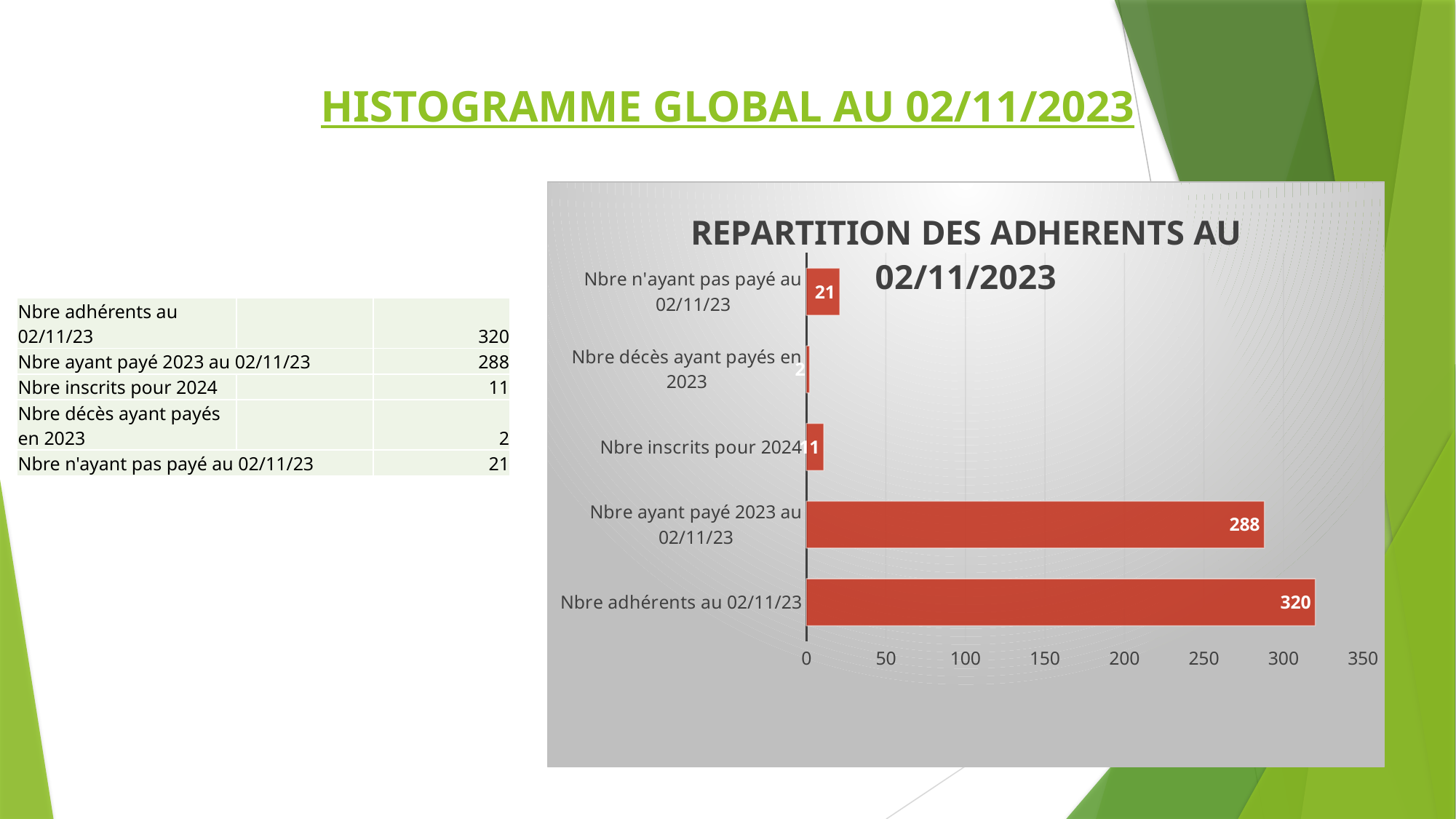
What is the value for "Nbre inscrits pour 2024"? 11 What is the value for "Nbre n'ayant pas payé au 02/11/23"? 21 Which category has the highest value? Nbre adhérents au 02/11/23 Which is larger: "Nbre n'ayant pas payé au 02/11/23" or "Nbre inscrits pour 2024"? Nbre n'ayant pas payé au 02/11/23 What is the difference between "Nbre adhérents au 02/11/23" and "Nbre ayant payé 2023 au 02/11/23"? 32 What is the value for "Nbre ayant payé 2023 au 02/11/23"? 288 How many categories does the chart show? 5 What is the title of the chart? REPARTITION DES ADHERENTS AU 02/11/2023 What type of chart is shown on the slide? bar chart What is the value for "Nbre adhérents au 02/11/23"? 320 Which category has the lowest value? Nbre décès ayant payés en 2023 Is the value for "Nbre ayant payé 2023 au 02/11/23" greater or less than 250? greater